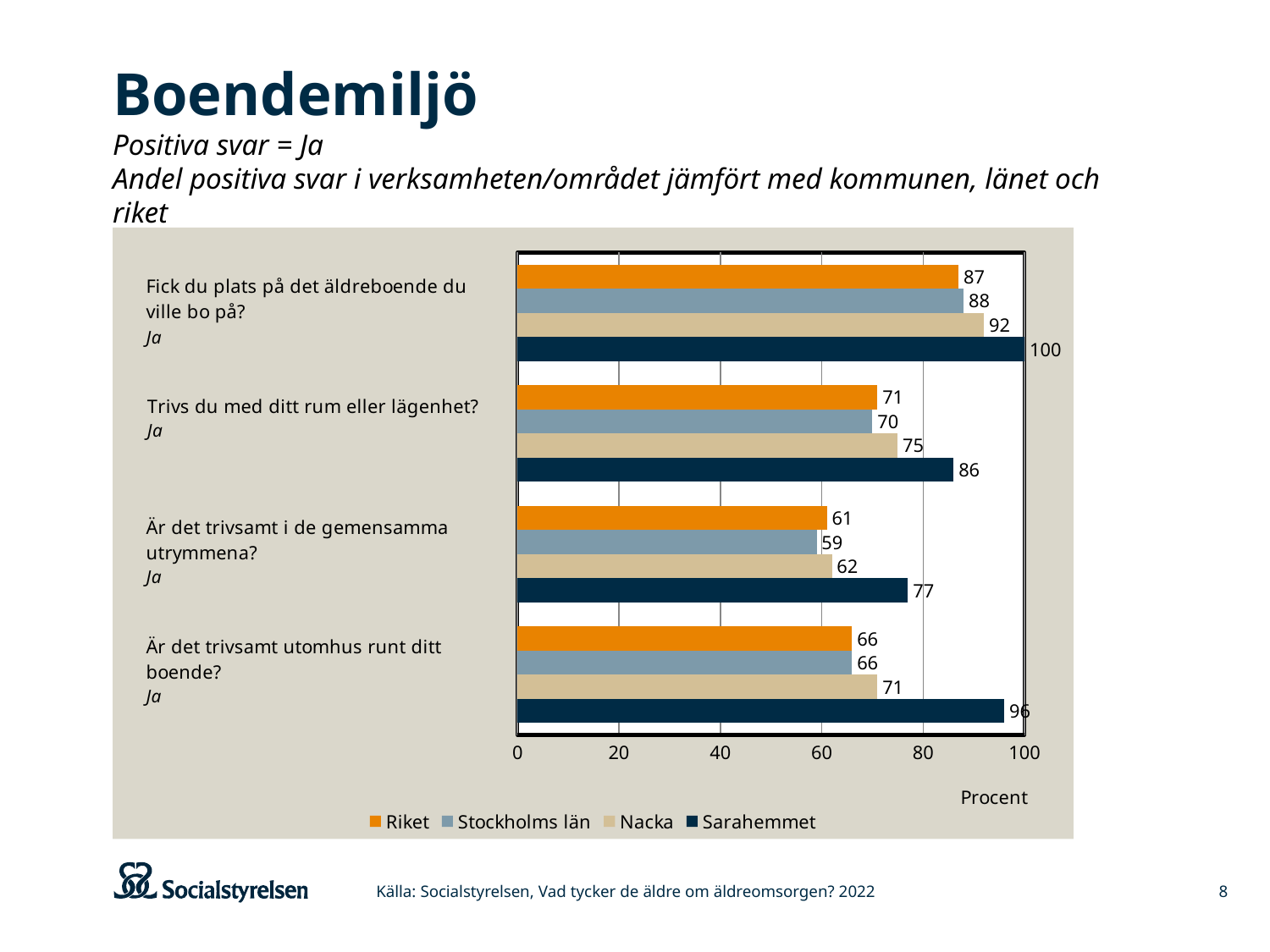
What unit is shown on the x axis of the chart? Procent What is the value for Riket on "Trivs du med ditt rum eller lägenhet?"? 71 Which is larger on "Fick du plats på det äldreboende du ville bo på?": Nacka or Riket? Nacka How many question categories are shown on the chart? 4 What is the value for Stockholms län on "Är det trivsamt utomhus runt ditt boende?"? 66 What kind of chart is shown on the slide? Bar chart What is the value for Nacka on "Är det trivsamt i de gemensamma utrymmena?"? 62 What is the value for Sarahemmet on "Fick du plats på det äldreboende du ville bo på?"? 100 Which series has the highest value on "Är det trivsamt utomhus runt ditt boende?"? Sarahemmet What is the difference between Sarahemmet and Riket on "Trivs du med ditt rum eller lägenhet?"? 15 Which series has the lowest value on "Är det trivsamt i de gemensamma utrymmena?"? Stockholms län How many series does the legend list? 4